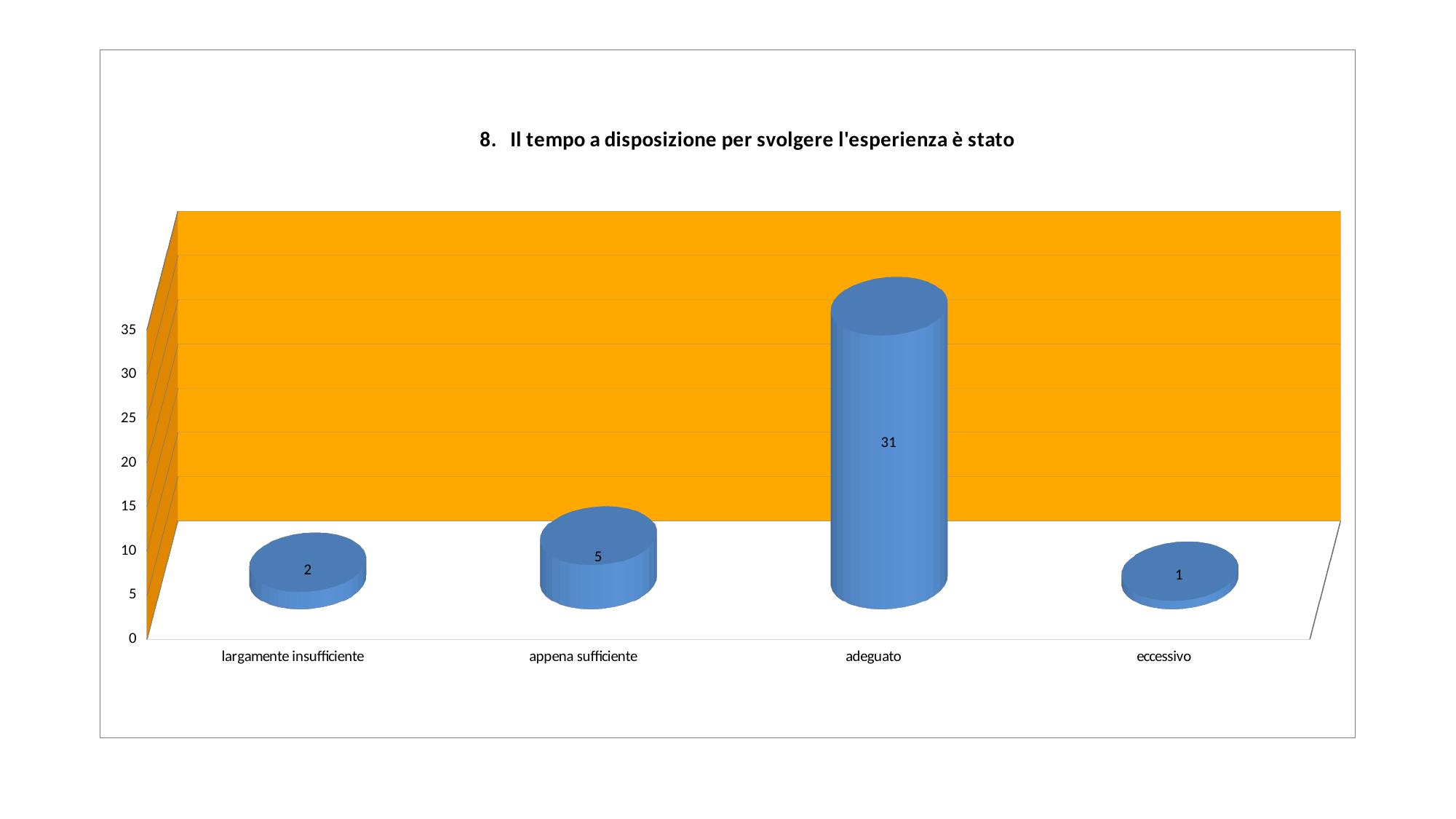
Which is larger, the value for "largamente insufficiente" or the value for "eccessivo"? largamente insufficiente What is the value for "largamente insufficiente"? 2 What is the title of the chart? 8. Il tempo a disposizione per svolgere l'esperienza è stato Is the value for "adeguato" greater or less than 30? greater What is the value for "adeguato"? 31 What is the value for "eccessivo"? 1 What is the difference between the values for "adeguato" and "appena sufficiente"? 26 How many categories are shown on the x axis? 4 What is the value for "appena sufficiente"? 5 What kind of chart is shown on the slide? bar chart Which category has the lowest value? eccessivo Which category has the highest value? adeguato